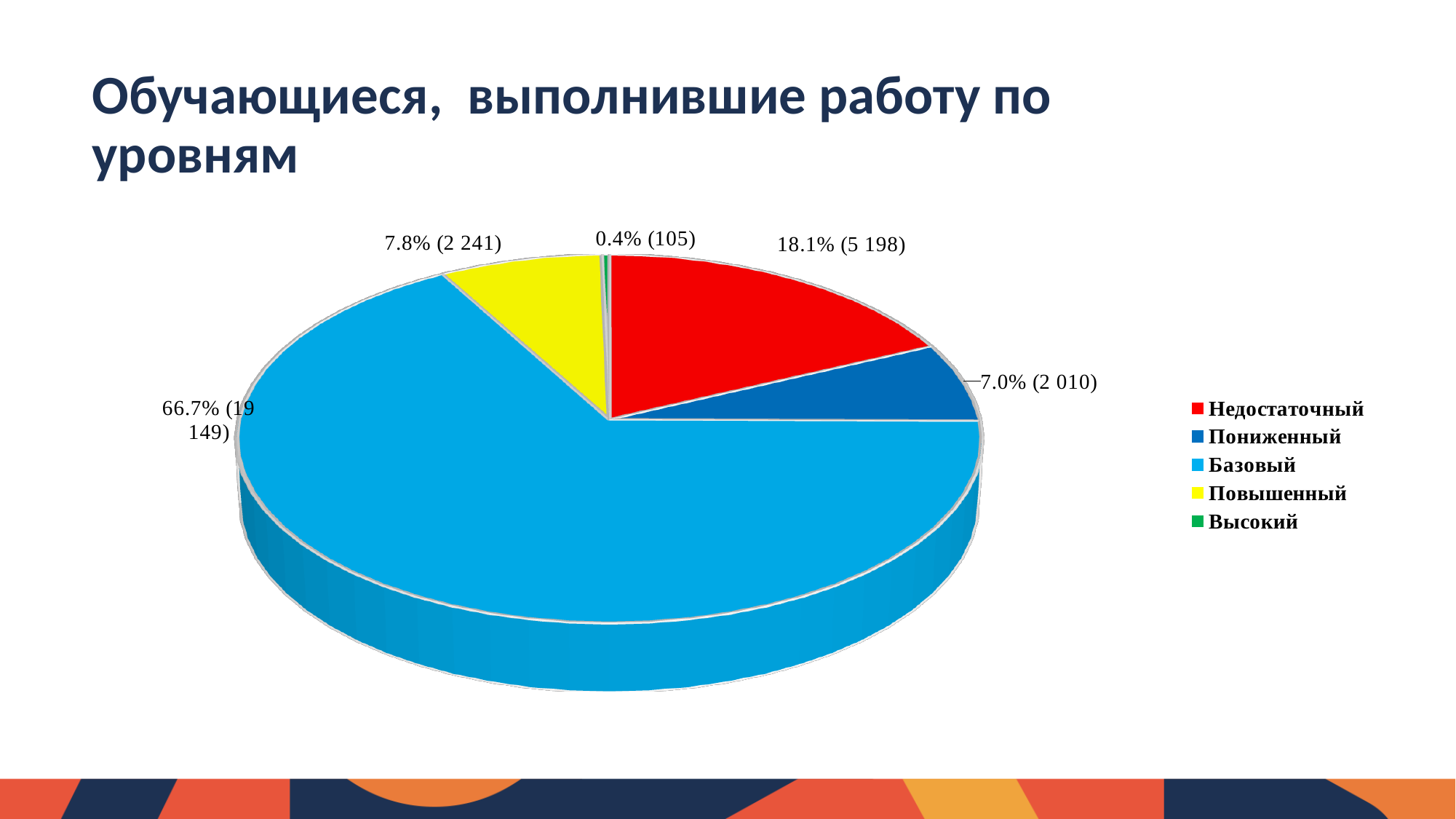
What share of the pie does the Базовый level have? 66.7% How many levels (slices) does the pie chart show? 5 Which level has the smallest slice of the pie? Высокий What type of chart is shown on the slide? Pie chart Which level has the largest slice of the pie? Базовый What colour is the Повышенный slice in the pie chart? Yellow How many students are in the Недостаточный level? 5 198 What is the difference in the number of students between the Недостаточный and Пониженный levels? 3 188 Which level has more students: Пониженный or Повышенный? Повышенный What percentage is shown for the Высокий level? 0.4% By how many percentage points does the Недостаточный share exceed the Пониженный share? 11.1% How many students are in the Повышенный level? 2 241